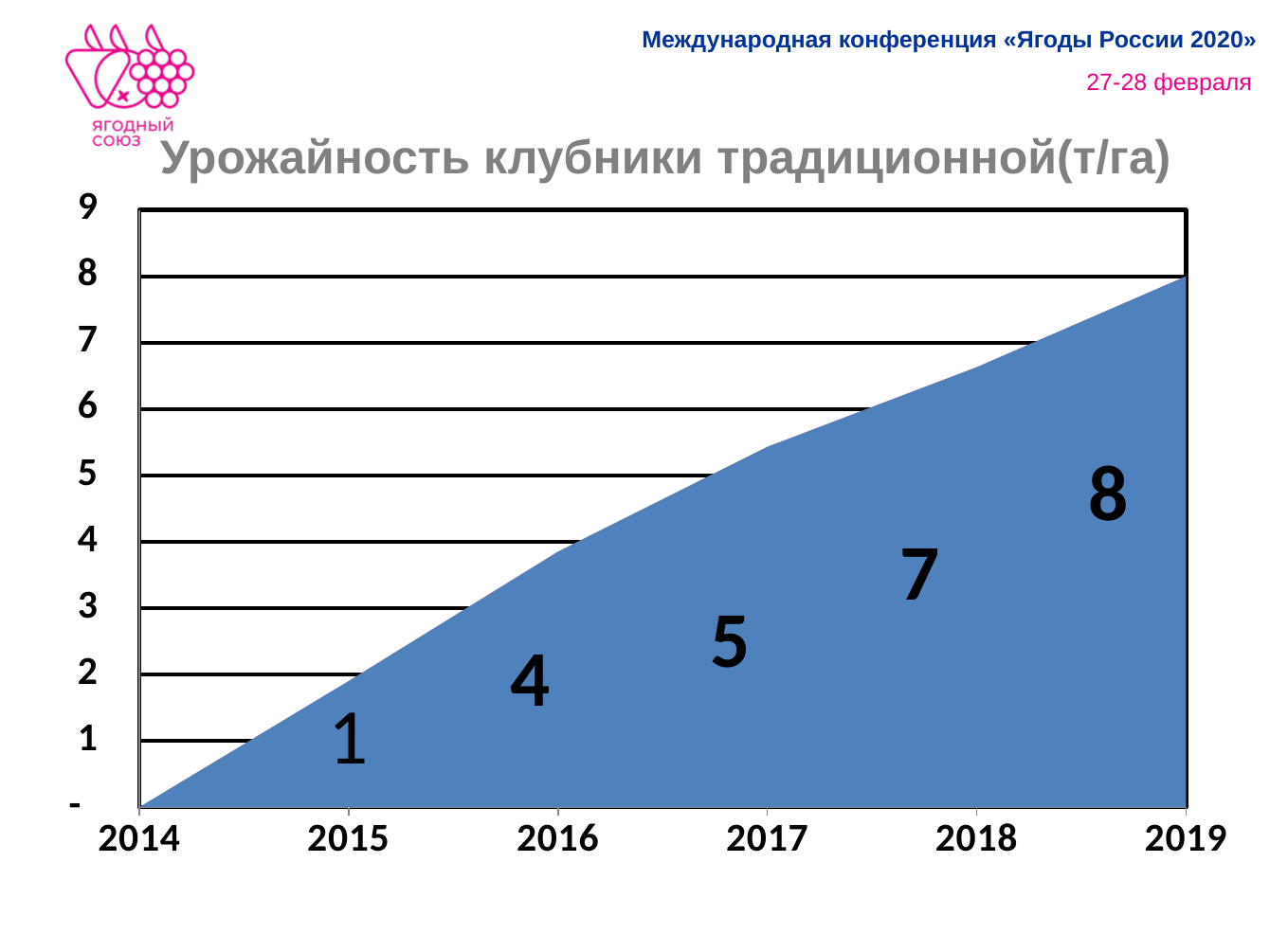
Do the yield values rise or fall from 2014 to 2019? rise Which year has the lowest yield? 2014 What is the yield value shown for 2016? 4 What is the difference between the yield in 2019 and the yield in 2016? 4 Which year has the larger yield, 2018 or 2016? 2018 What is the yield value shown for 2019? 8 What is the title of the chart? Урожайность клубники традиционной(т/га) What kind of chart is shown on the slide? area chart What is the yield value shown for 2018? 7 Is the yield value for 2014 greater or less than 1? less How many years are plotted along the x axis? 6 Which year has the highest yield? 2019